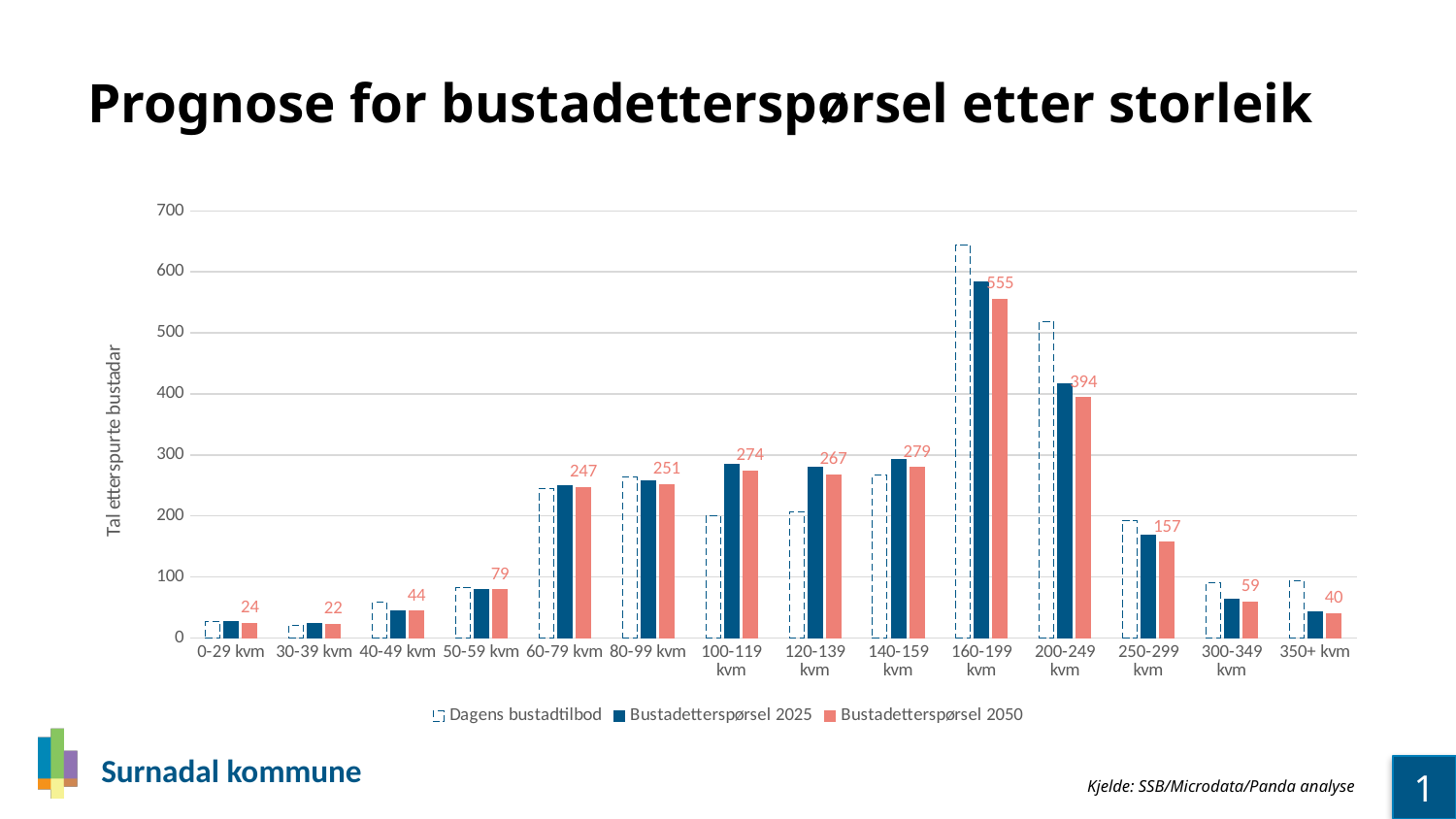
What type of chart is shown on the slide? Bar chart Is the Bustadetterspørsel 2025 value for 250-299 kvm greater or less than 200? less How many series does the legend list? 3 What is the Bustadetterspørsel 2050 value for 160-199 kvm? 555 Is the Dagens bustadtilbod value for 160-199 kvm greater or less than 600? greater Which is larger, the Bustadetterspørsel 2050 value for 140-159 kvm or for 120-139 kvm? 140-159 kvm What is the Bustadetterspørsel 2050 value for 200-249 kvm? 394 What is the difference between the Bustadetterspørsel 2050 values for 160-199 kvm and 200-249 kvm? 161 What is the Bustadetterspørsel 2050 value for 0-29 kvm? 24 Which size category has the highest Bustadetterspørsel 2050 value? 160-199 kvm Which size category has the lowest Bustadetterspørsel 2050 value? 30-39 kvm How many size categories are shown on the x axis? 14